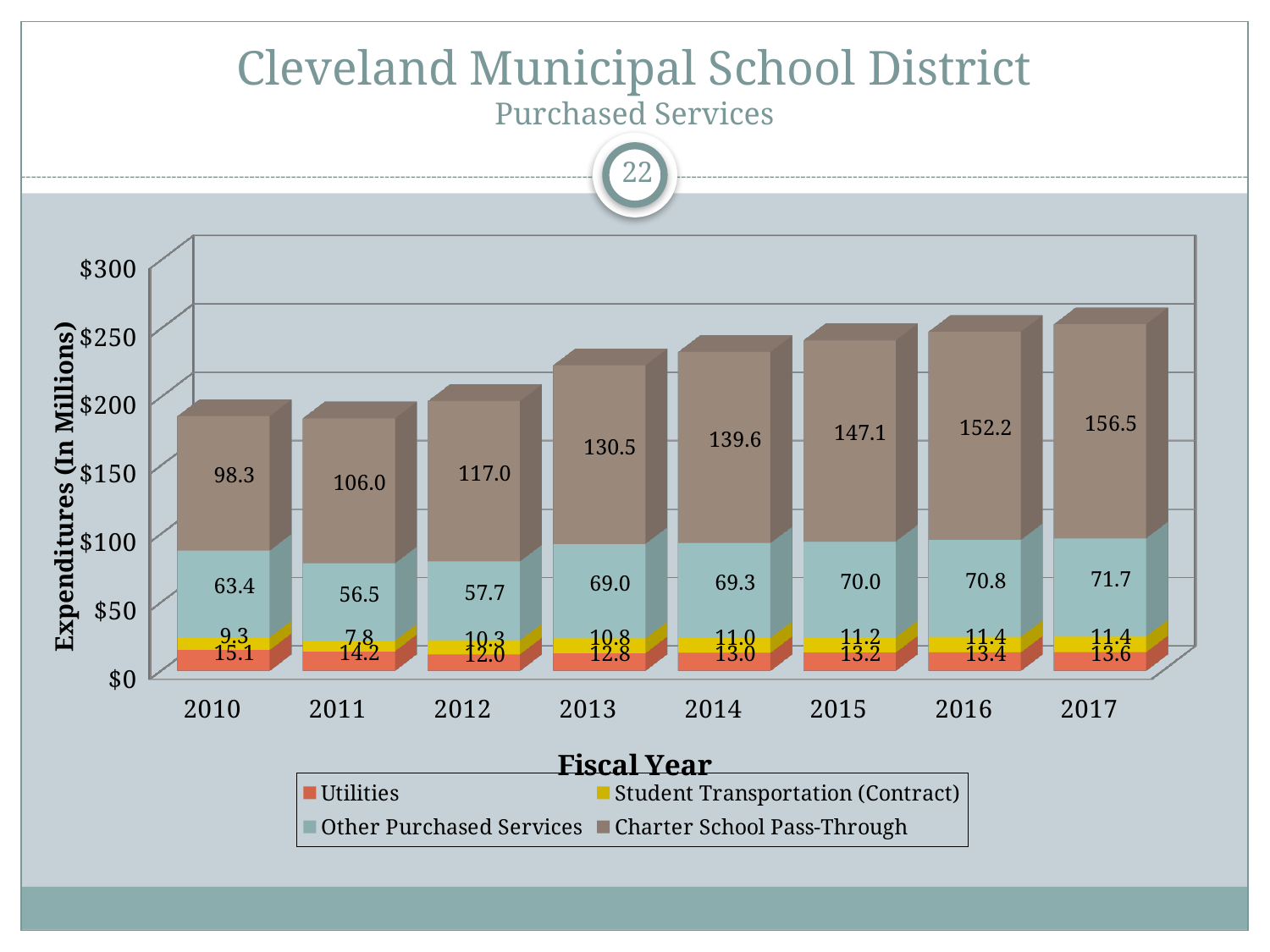
What is the Utilities value for 2010? 15.1 How many fiscal years are shown on the x axis? 8 How many series does the legend list? 4 What is the difference between the Charter School Pass-Through values for 2017 and 2010? 58.2 Does the Charter School Pass-Through value rise or fall from 2010 to 2017? Rise What is the Charter School Pass-Through value for 2014? 139.6 In which fiscal year is the Student Transportation (Contract) value lowest? 2011 What is the total of the stacked bar for 2017? 253.2 Which is larger, the Other Purchased Services value for 2013 or for 2012? 2013 What type of chart is shown on the slide? Stacked bar chart In which fiscal year is the Charter School Pass-Through value highest? 2017 What is the Other Purchased Services value for 2011? 56.5